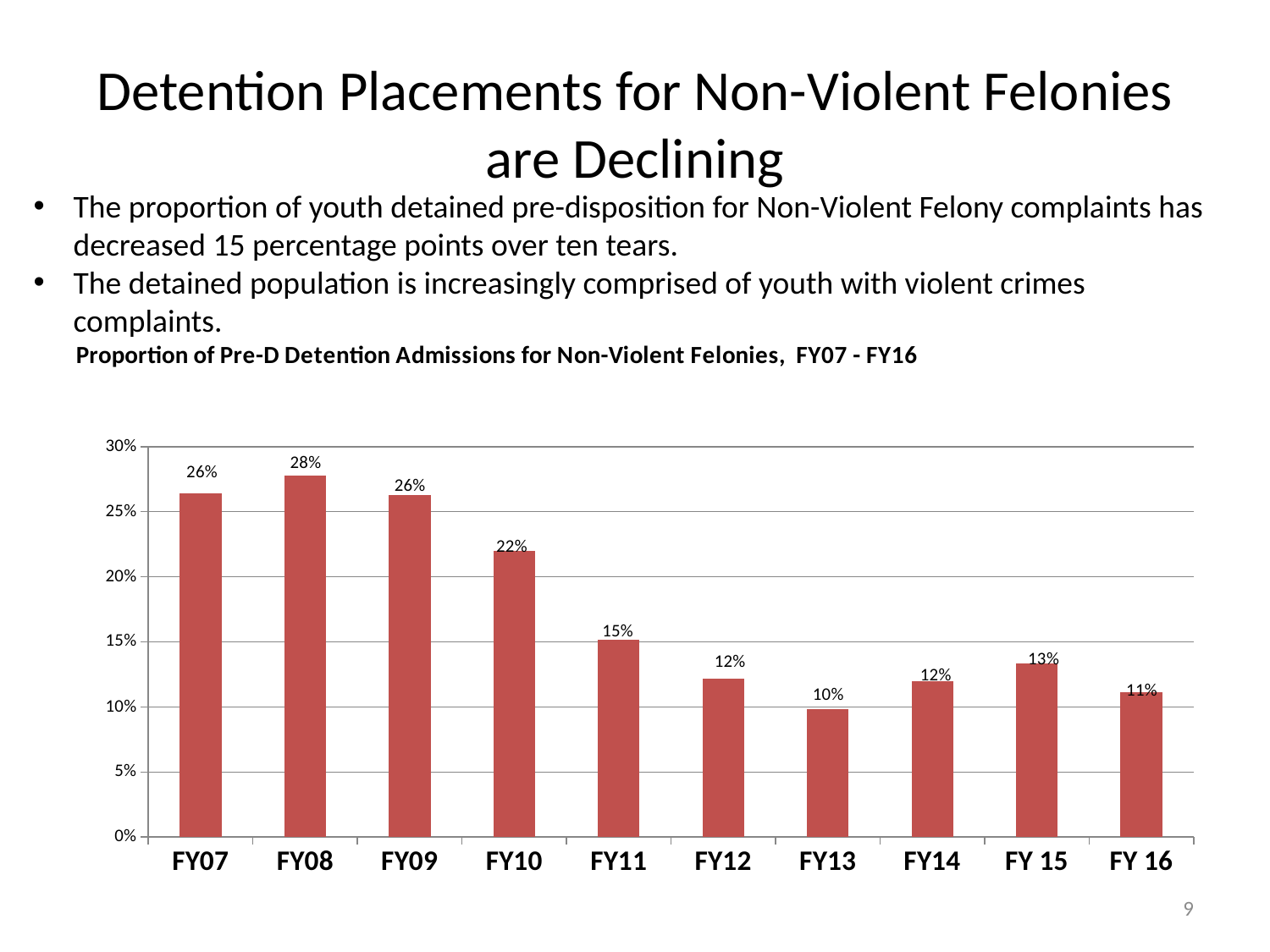
What is the value for FY08? 28% What is the difference between the values for FY08 and FY13? 18 percentage points What is the value for FY 16? 11% What is the value for FY13? 10% Which is larger, the value for FY10 or the value for FY11? FY10 What is the title of the chart? Proportion of Pre-D Detention Admissions for Non-Violent Felonies, FY07 - FY16 How many fiscal years are shown on the x axis? 10 Which fiscal year has the highest proportion? FY08 Which fiscal year has the lowest proportion? FY13 What kind of chart is shown? bar chart Is the value for FY09 greater or less than 25%? greater Do the values generally rise or fall from FY07 to FY 16? fall